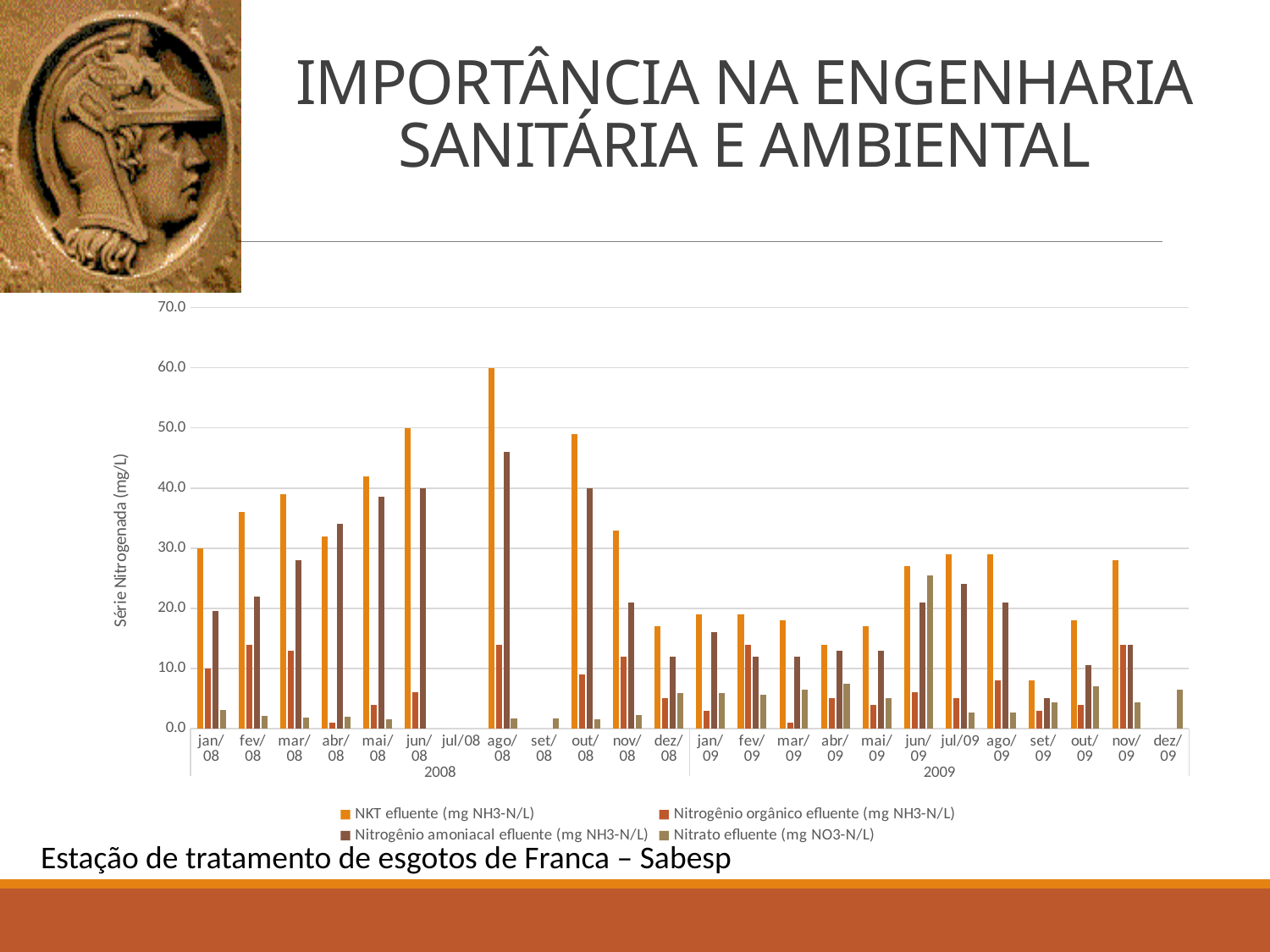
What is the label on the vertical axis of the chart? Série Nitrogenada (mg/L) Is the Nitrato efluente value for jun/09 greater or less than 20? greater In which month does the NKT efluente series reach its highest value? ago/08 Which is larger, the NKT efluente value for ago/08 or for jun/08? ago/08 What kind of chart is shown on the slide? bar chart Is the Nitrogênio amoniacal efluente value for ago/08 greater or less than 40? greater How many months (categories) are shown along the x axis of the chart? 24 Is the NKT efluente value for ago/08 greater or less than 50? greater How many series does the chart legend list? 4 Which is larger, the NKT efluente value for mar/08 or for mar/09? mar/08 Are the NKT efluente values generally higher in 2008 or in 2009? 2008